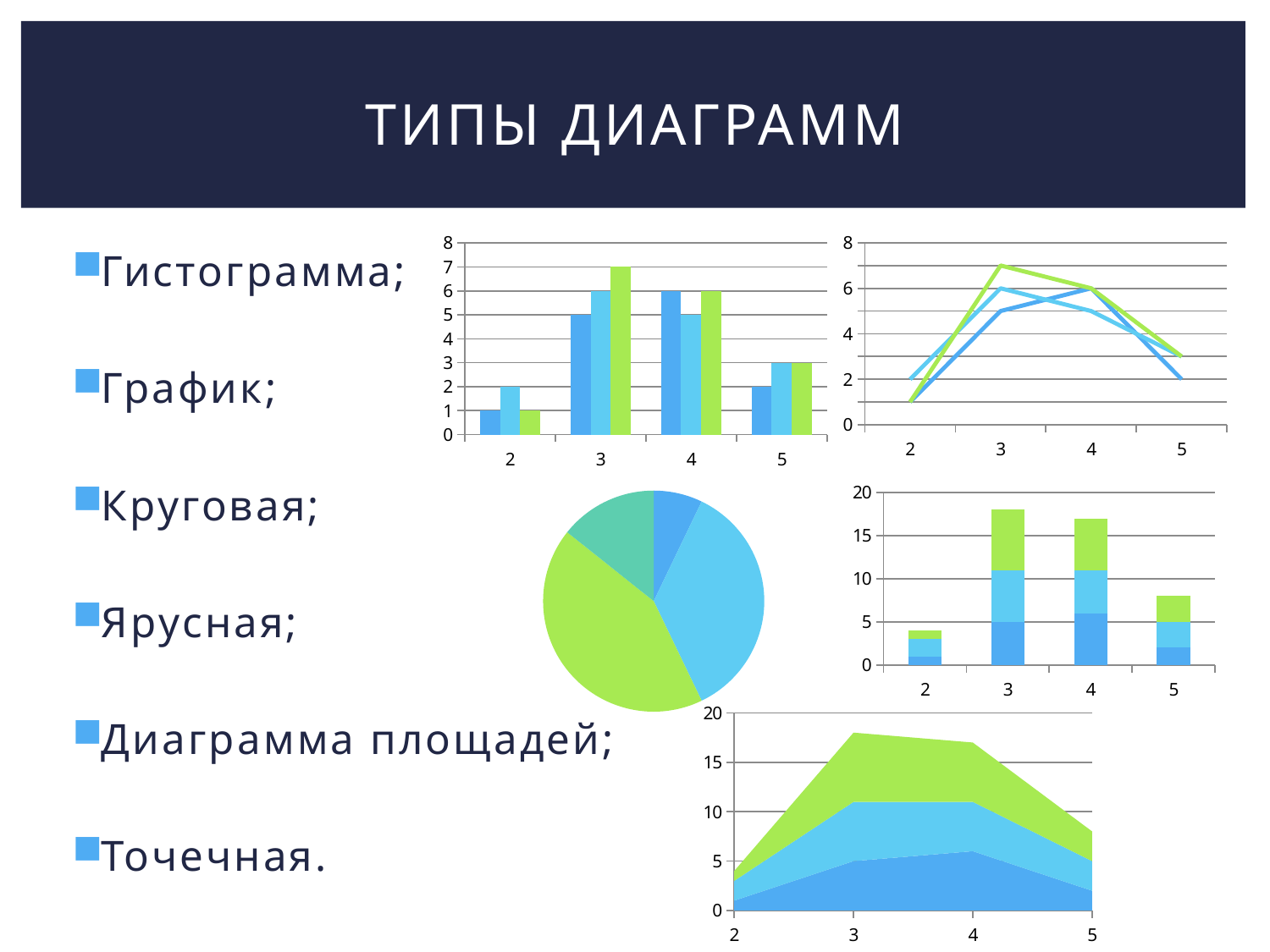
In the top-left bar chart, what is the value of the green bar for category 3? 7 What type of chart is the top-left chart on the slide? bar chart In the top-left bar chart, which category has the tallest bar overall? 3 In the top-left bar chart, what is the difference between the green bar for category 3 and the green bar for category 2? 6 In the stacked bar chart on the right, is the total for category 3 greater or less than 15? greater How many slices does the pie chart have? 4 In the top-left bar chart, what is the value of the dark blue bar for category 4? 6 In the stacked bar chart on the right, is the total for category 5 greater or less than 10? less How many categories are shown on the x axis of the top-left bar chart? 4 What type of chart is the top-right chart on the slide? line chart What type of chart is the chart in the middle of the slide, below the top-left chart? pie chart